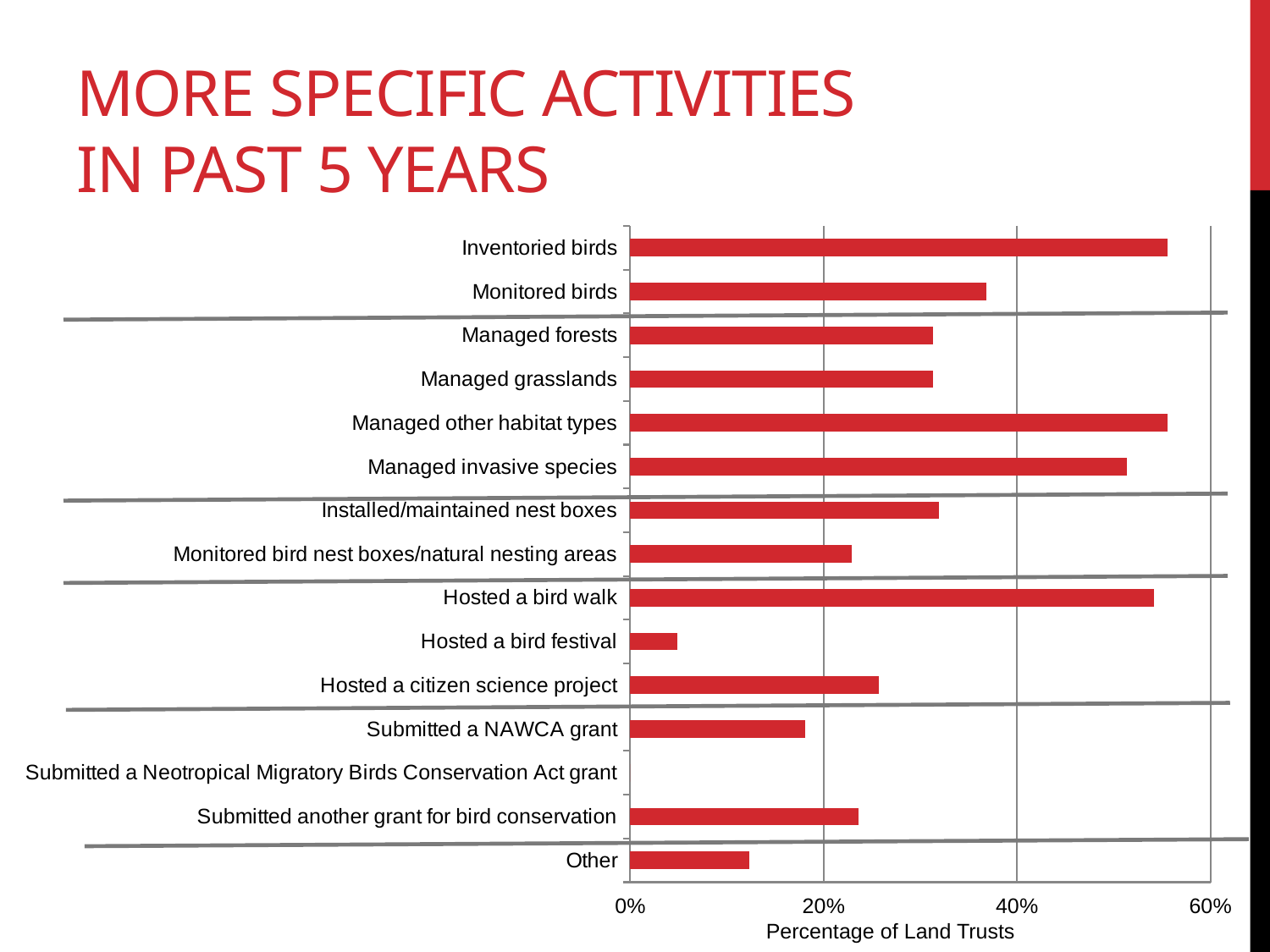
What is the label of the horizontal axis? Percentage of Land Trusts Which activity has the lowest value on the chart? Submitted a Neotropical Migratory Birds Conservation Act grant Is the value for Inventoried birds greater or less than 40%? greater Is the value for Submitted a NAWCA grant greater or less than 20%? less Which is larger, the value for Monitored birds or the value for Managed forests? Monitored birds Is the value for Managed invasive species greater or less than 40%? greater Which is larger, the value for Other or the value for Hosted a bird festival? Other How many activity categories are listed on the chart? 15 Which is larger, the value for Hosted a bird walk or the value for Hosted a citizen science project? Hosted a bird walk What kind of chart is shown on the slide? bar chart